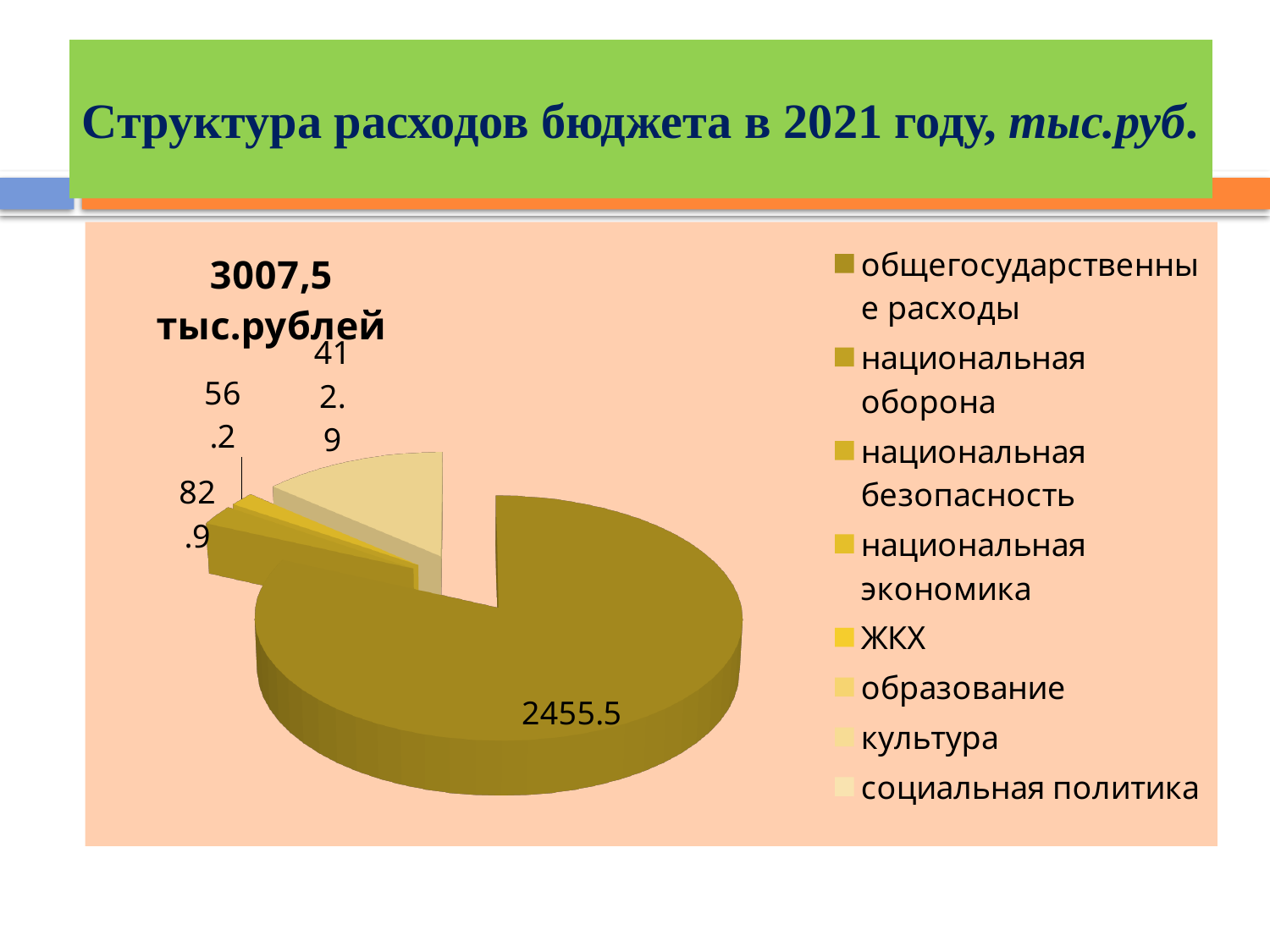
Which is larger in the pie chart: the slice labelled 2455.5 or the slice labelled 412.9? 2455.5 What is the value labelled on the largest slice of the pie chart? 2455.5 What is the smallest value labelled on the pie chart? 56.2 What is the value for общегосударственные расходы in the pie chart? 2455.5 How many categories does the legend of the pie chart list? 8 Which category has the largest slice in the pie chart? общегосударственные расходы What kind of chart is shown on the slide? pie chart Is the value for общегосударственные расходы greater or less than 2000? greater What is the title of the slide? Структура расходов бюджета в 2021 году, тыс.руб. What is the last category listed in the legend of the pie chart? социальная политика What total amount is shown in the title of the pie chart? 3007,5 тыс.рублей